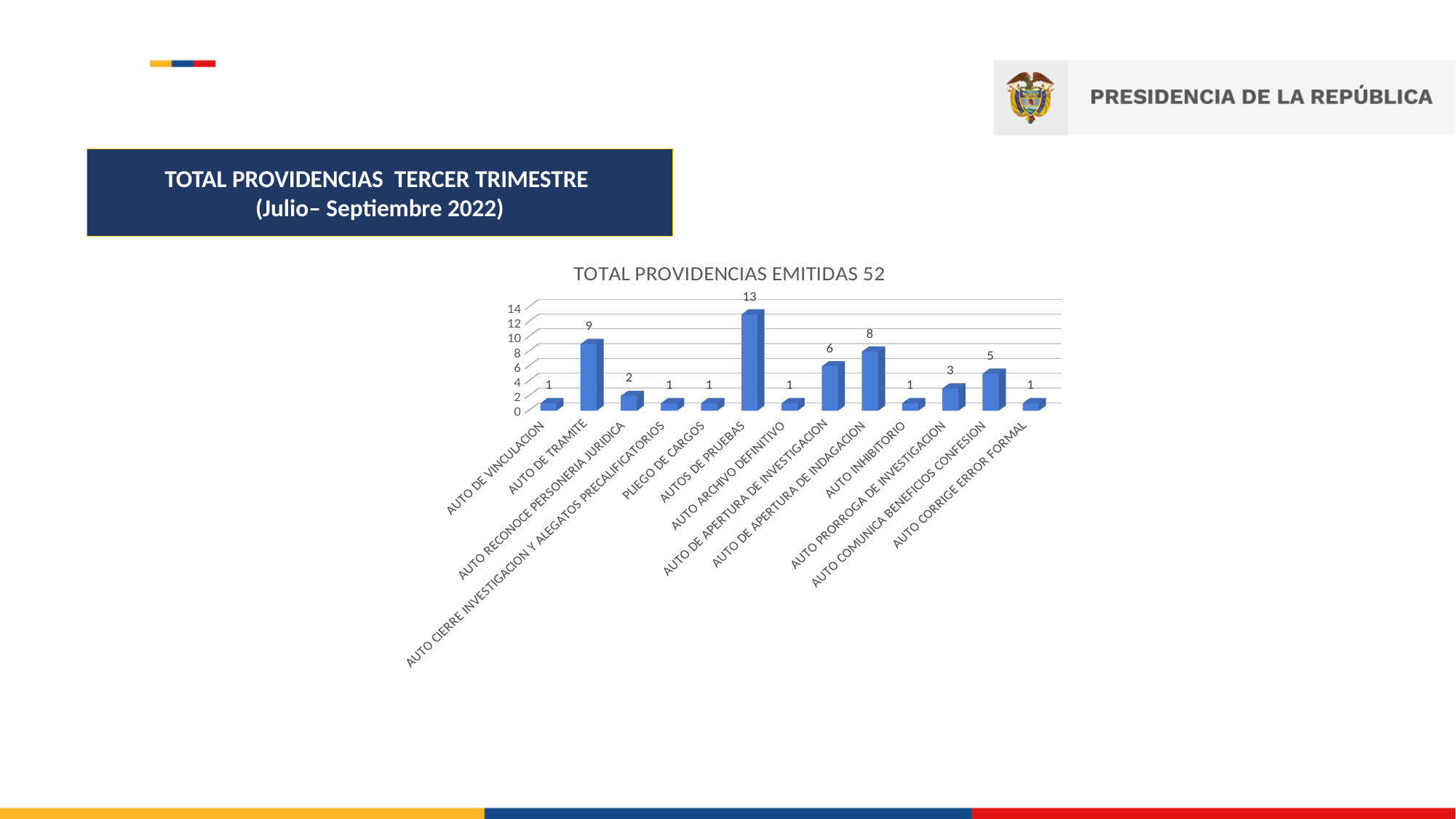
What type of chart is shown on the slide? bar chart What is the value for AUTO COMUNICA BENEFICIOS CONFESION? 5 What is the value for AUTO DE APERTURA DE INDAGACION? 8 How many categories are plotted in the chart? 13 What is the difference between the values for AUTOS DE PRUEBAS and AUTO DE TRAMITE? 4 What is the value for AUTO DE TRAMITE? 9 Which category has the highest value? AUTOS DE PRUEBAS What is the title of the chart? TOTAL PROVIDENCIAS EMITIDAS 52 Which is larger, the value for AUTO DE APERTURA DE INVESTIGACION or AUTO DE APERTURA DE INDAGACION? AUTO DE APERTURA DE INDAGACION Is the value for AUTO DE APERTURA DE INVESTIGACION greater or less than 4? greater What is the value for AUTOS DE PRUEBAS? 13 What is the difference between the values for AUTO PRORROGA DE INVESTIGACION and AUTO RECONOCE PERSONERIA JURIDICA? 1